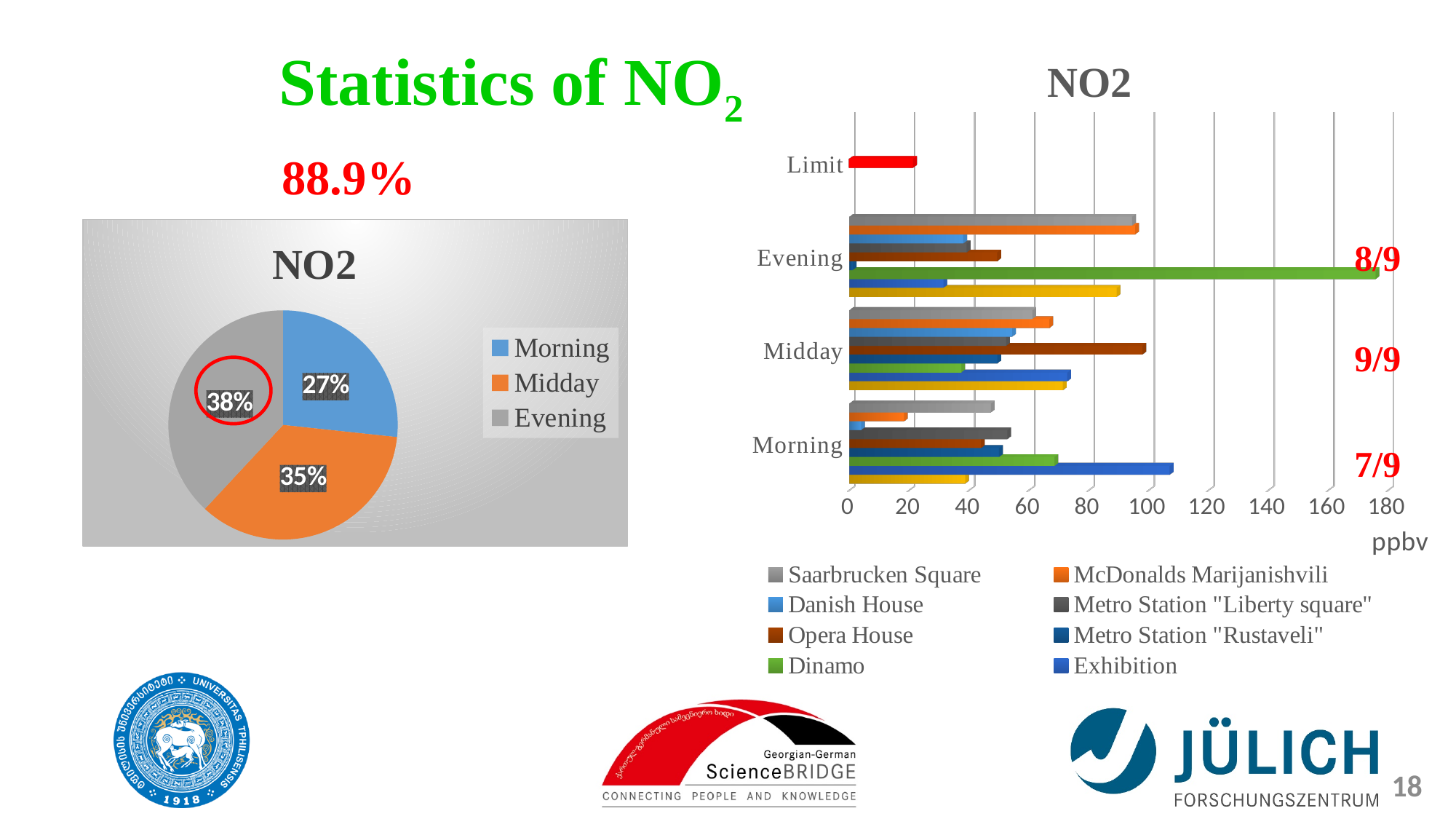
In the pie chart on the left, what percentage is shown for Morning? 27% In the pie chart on the left, what percentage is shown for Evening? 38% In the pie chart on the left, which time of day has the largest share? Evening In the bar chart on the right, how many categories are shown on the vertical axis? 4 In the pie chart on the left, what is the difference in percentage points between the Evening and Morning shares? 11 In the bar chart on the right, what unit is shown on the horizontal axis? ppbv In the pie chart on the left, how many slices are there? 3 In the bar chart on the right, is the value for Limit greater or less than 40? less What kind of chart is the chart on the right of the slide? bar chart In the bar chart on the right, is the value for Dinamo in the Evening greater or less than 160? greater In the pie chart on the left, which time of day has the smallest share? Morning In the bar chart on the right, how many series does the legend list? 8